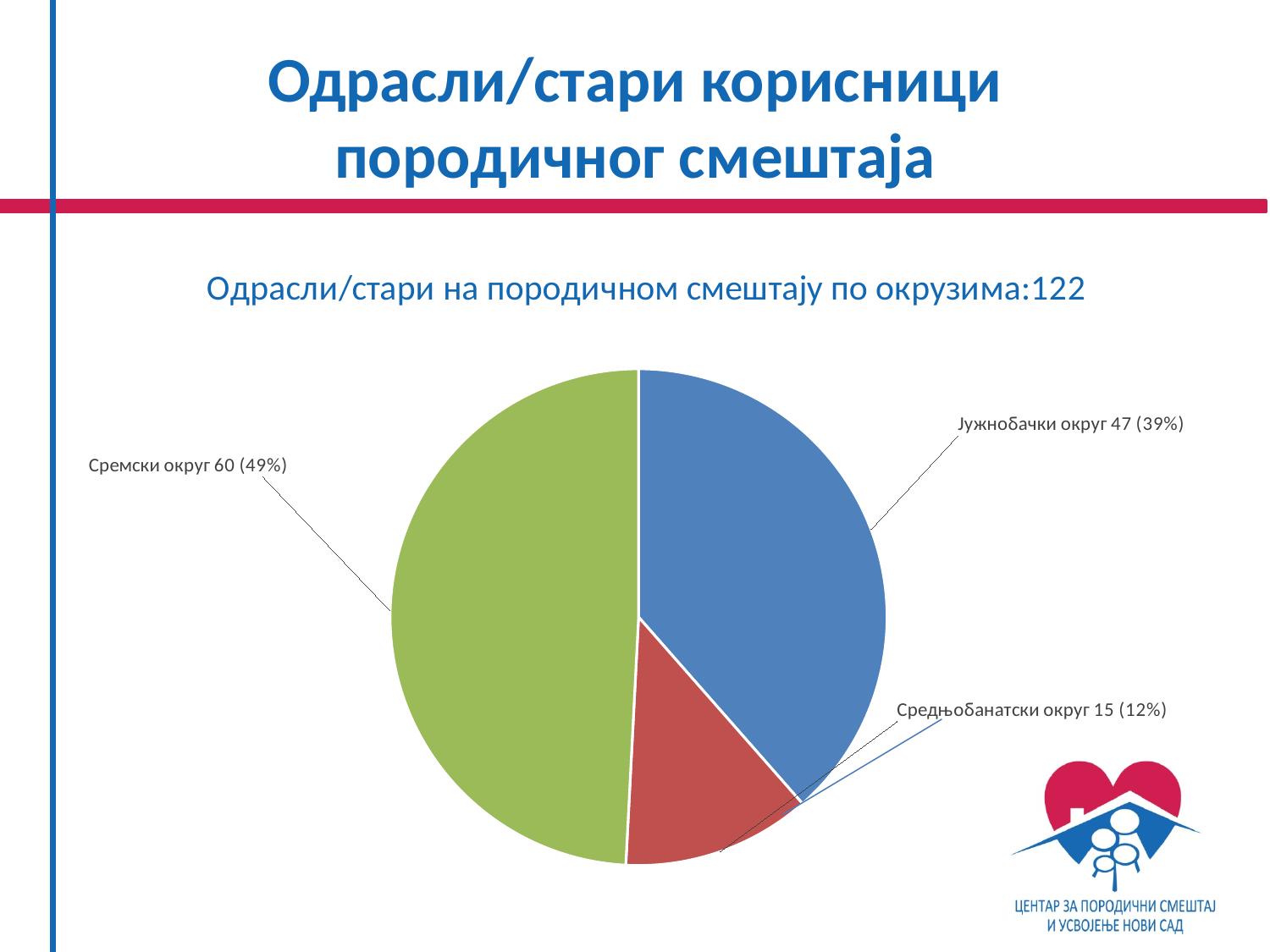
What share of the pie does Јужнобачки округ represent? 39% What is the difference between the values for Сремски округ and Јужнобачки округ? 13 What is the value for Сремски округ? 60 What total number is given in the chart title? 122 Which is larger, the value for Јужнобачки округ or Средњобанатски округ? Јужнобачки округ Which district has the largest slice? Сремски округ What is the value for Јужнобачки округ? 47 How many slices does the pie chart have? 3 Which district has the smallest slice? Средњобанатски округ What share of the pie does Средњобанатски округ represent? 12% What is the value for Средњобанатски округ? 15 What kind of chart is shown on the slide? pie chart